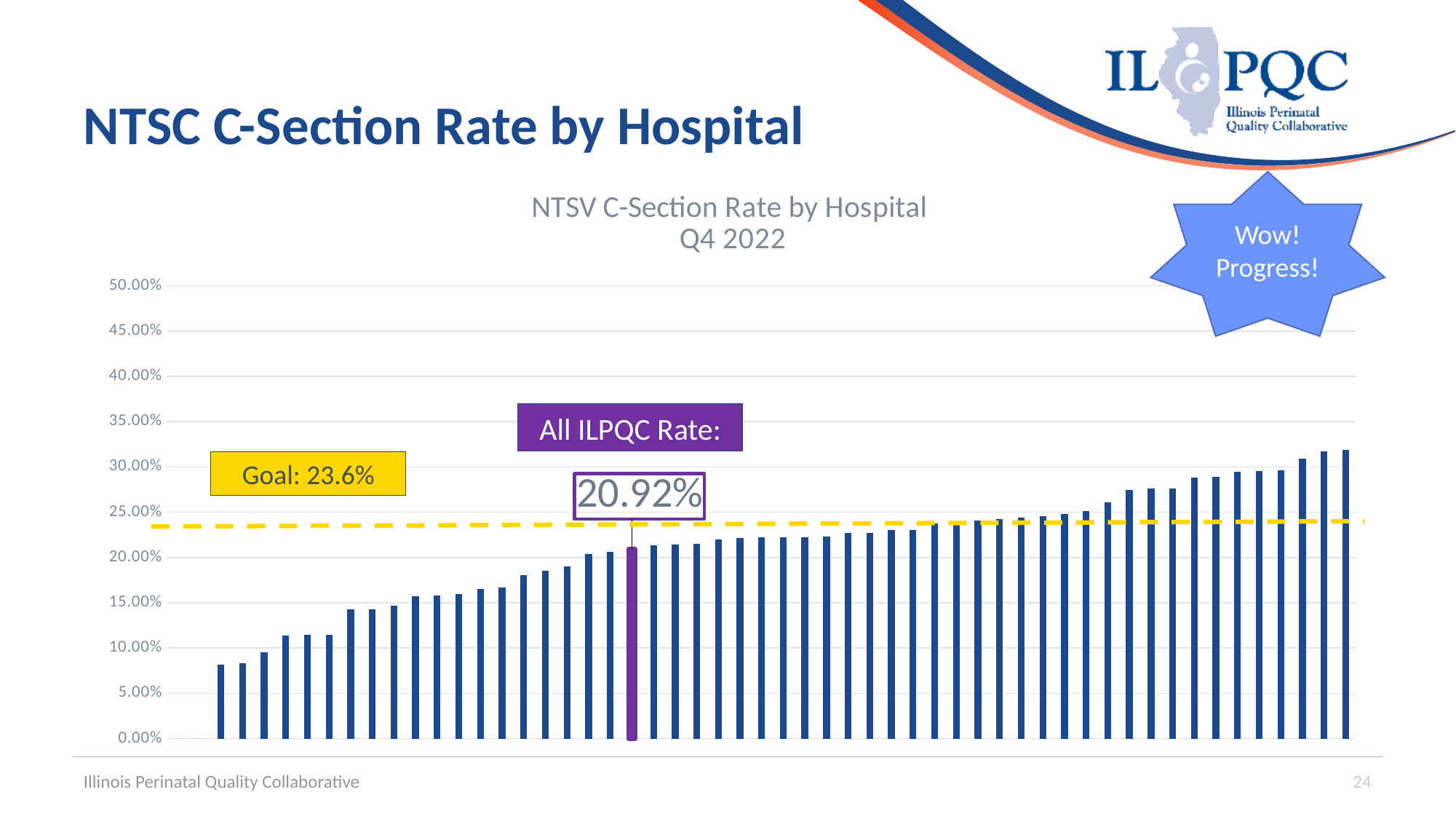
What is the highest value shown on the vertical axis? 50.00% What is the title of the chart? NTSV C-Section Rate by Hospital Q4 2022 Is the shortest bar on the chart greater or less than 10.00%? less What colour is the bar that marks the All ILPQC Rate? Purple What kind of chart is shown on the slide? Bar chart Is the All ILPQC Rate greater or less than 25.00%? less What goal value is shown on the chart? 23.6% Is the tallest bar on the chart greater or less than 30.00%? greater Do the bar values rise or fall from left to right across the chart? rise What is the All ILPQC Rate shown on the chart? 20.92%